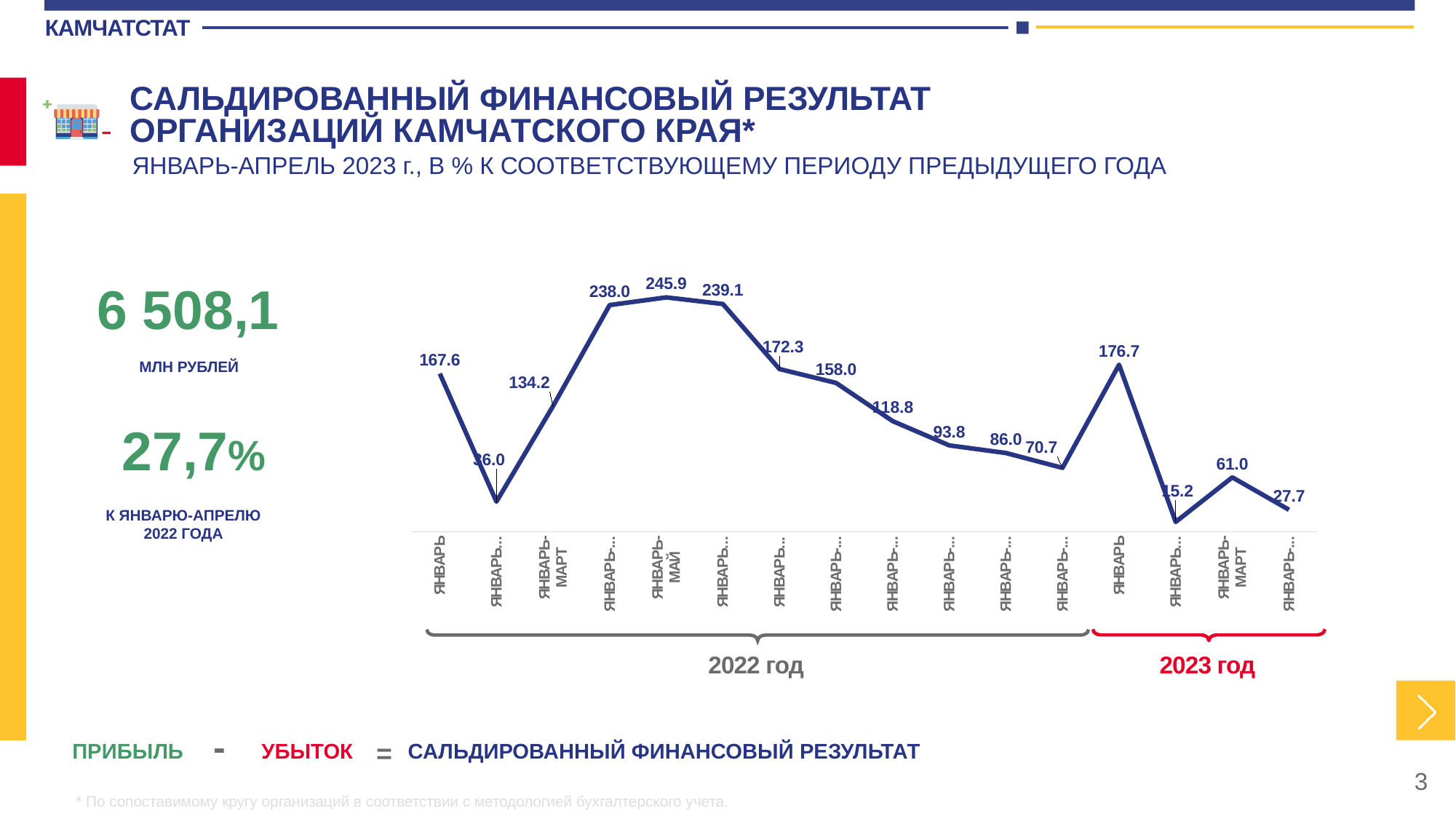
What is the value for ЯНВАРЬ in the 2023 group? 176.7 What is the difference between the value for ЯНВАРЬ 2023 and ЯНВАРЬ 2022? 9.1 Do the values rise or fall from ЯНВАРЬ-МАЙ 2022 to the last point of the 2022 group? fall What is the value for ЯНВАРЬ-МАРТ in the 2023 group? 61.0 What is the value for ЯНВАРЬ-МАРТ in the 2022 group? 134.2 How many data points are plotted on the line chart? 16 What kind of chart is shown on the slide? line chart Which period has the highest value on the line chart? ЯНВАРЬ-МАЙ 2022 What is the value for ЯНВАРЬ in the 2022 group? 167.6 Which is larger: the value for ЯНВАРЬ-МАРТ 2022 or ЯНВАРЬ-МАРТ 2023? ЯНВАРЬ-МАРТ 2022 What is the lowest value on the line chart? 15.2 What is the highest value on the line chart? 245.9